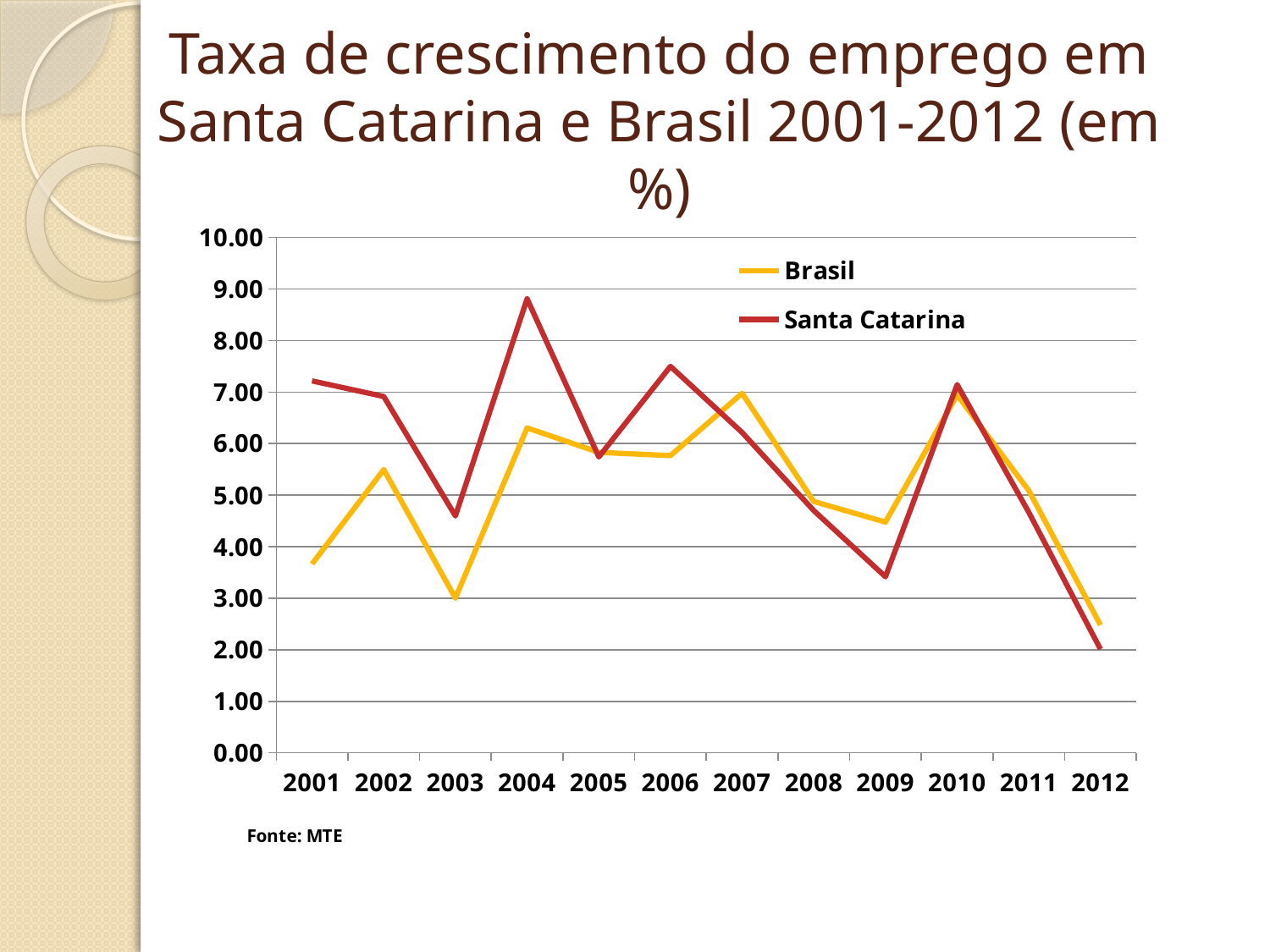
In 2001, which series has the higher value, Brasil or Santa Catarina? Santa Catarina What kind of chart is shown on the slide? line chart In which year does the Santa Catarina series reach its highest value? 2004 Is the value for Brasil in 2001 greater or less than 4.00? less How many series does the legend list? 2 Is the value for Santa Catarina in 2009 greater or less than 4.00? less Do the values for both series rise or fall from 2010 to 2012? fall In 2007, which series has the higher value, Brasil or Santa Catarina? Brasil In which year does the Brasil series reach its lowest value? 2012 How many years are plotted along the x axis? 12 Is the value for Santa Catarina in 2004 greater or less than 8.00? greater In which year does the Santa Catarina series reach its lowest value? 2012